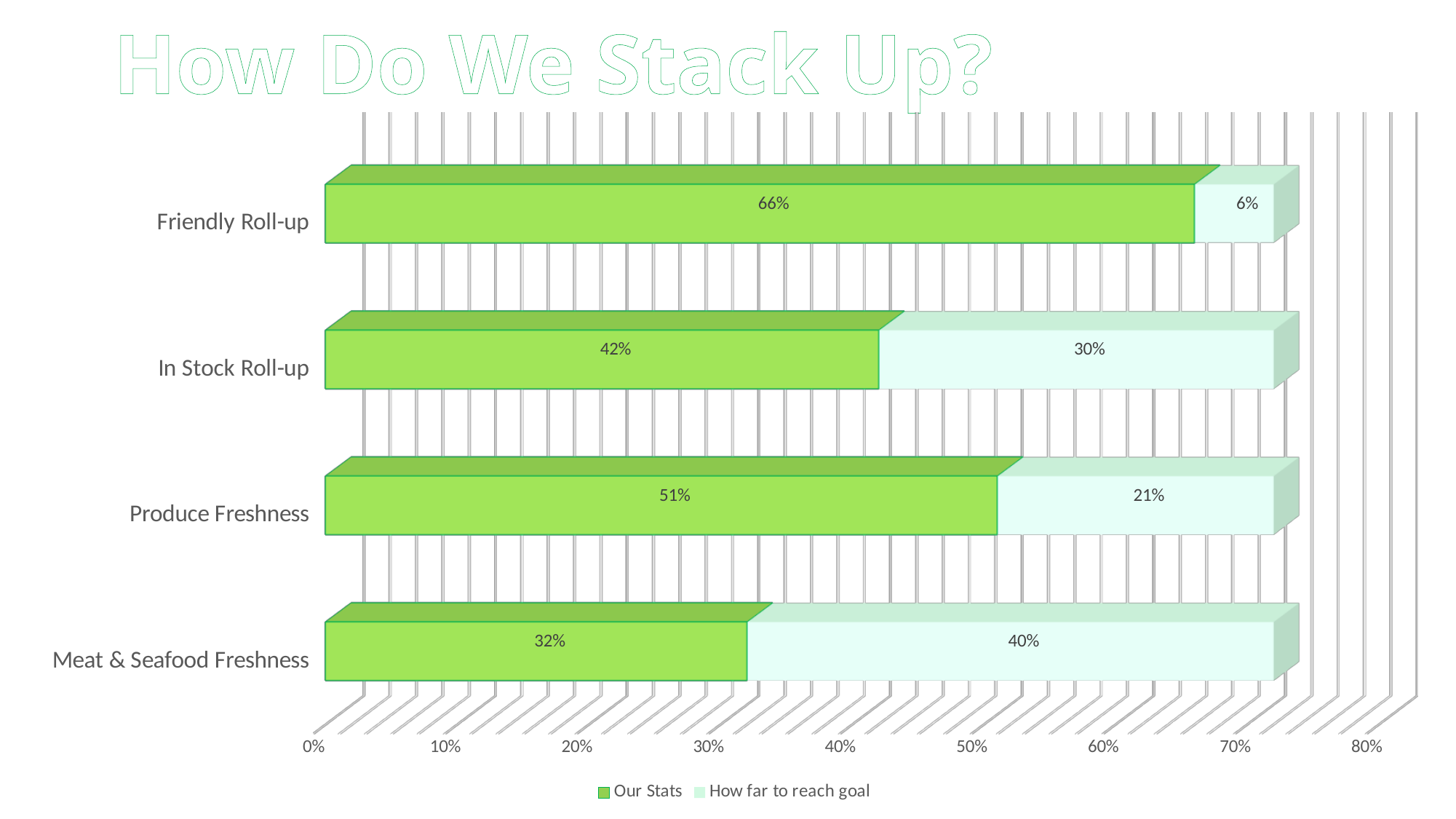
What is the difference between the 'Our Stats' values for Produce Freshness and In Stock Roll-up? 9% Which category has the highest 'Our Stats' value? Friendly Roll-up Which category has the lowest 'How far to reach goal' value? Friendly Roll-up How many categories are shown on the chart? 4 How many series does the legend list? 2 What is the 'How far to reach goal' value for Produce Freshness? 21% What is the 'Our Stats' value for Friendly Roll-up? 66% What kind of chart is shown on the slide? Stacked bar chart What is the total of the stacked bar for Meat & Seafood Freshness? 72% Which is larger: the 'Our Stats' value for In Stock Roll-up or for Meat & Seafood Freshness? In Stock Roll-up What is the 'Our Stats' value for Meat & Seafood Freshness? 32% What is the 'How far to reach goal' value for In Stock Roll-up? 30%